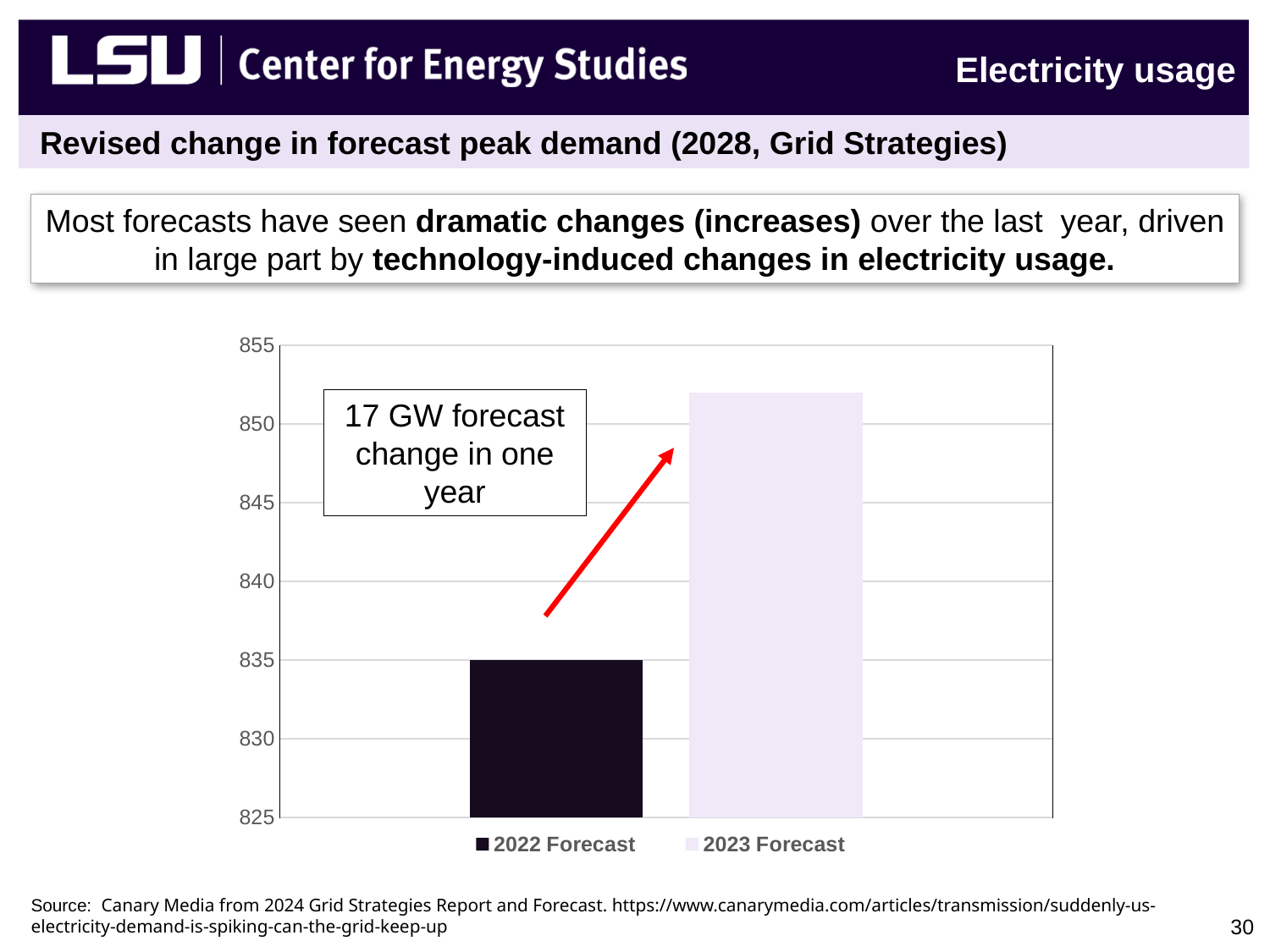
What is the highest value shown on the vertical axis of the chart? 855 What kind of chart is shown on the slide? Bar chart How many series does the legend list? 2 Which series has the lowest value in the chart? 2022 Forecast How many bars are plotted in the chart? 2 Which series has the highest value in the chart? 2023 Forecast Which series has the higher bar, 2022 Forecast or 2023 Forecast? 2023 Forecast What is the value of the 2022 Forecast bar? 835 Is the value for 2022 Forecast greater or less than 840? less According to the text box on the chart, how large is the forecast change in one year? 17 GW Is the value for 2023 Forecast greater or less than 850? greater Do the values rise or fall from the 2022 Forecast to the 2023 Forecast? Rise